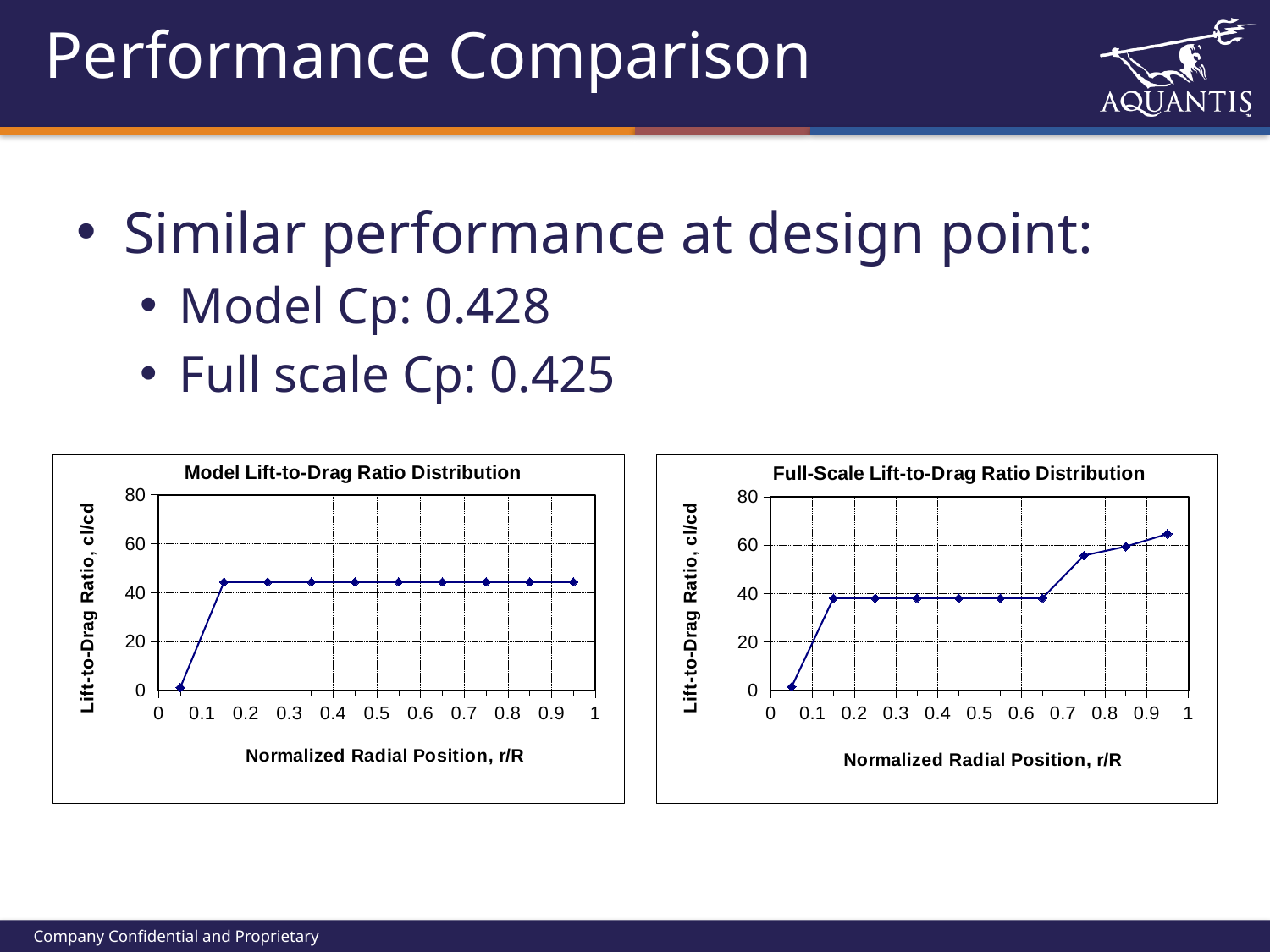
In the Full-Scale Lift-to-Drag Ratio Distribution chart, is the value at r/R = 0.95 greater or less than 60? greater How many data points are plotted in the Full-Scale Lift-to-Drag Ratio Distribution chart? 10 What kind of chart is the Full-Scale Lift-to-Drag Ratio Distribution chart? line chart In the Model Lift-to-Drag Ratio Distribution chart, at which normalized radial position is the lift-to-drag ratio lowest? 0.05 In the Full-Scale Lift-to-Drag Ratio Distribution chart, at which normalized radial position is the lift-to-drag ratio highest? 0.95 In the Full-Scale Lift-to-Drag Ratio Distribution chart, do the values rise or fall between r/R = 0.7 and r/R = 1? rise In the Full-Scale Lift-to-Drag Ratio Distribution chart, is the value at r/R = 0.05 greater or less than 20? less In the Model Lift-to-Drag Ratio Distribution chart, is the value at r/R = 0.5 greater or less than 60? less What is the label of the x axis in the Model Lift-to-Drag Ratio Distribution chart? Normalized Radial Position, r/R What kind of chart is the Model Lift-to-Drag Ratio Distribution chart? line chart At r/R = 0.95, which chart shows the larger lift-to-drag ratio, the Model chart or the Full-Scale chart? Full-Scale How many data points are plotted in the Model Lift-to-Drag Ratio Distribution chart? 10